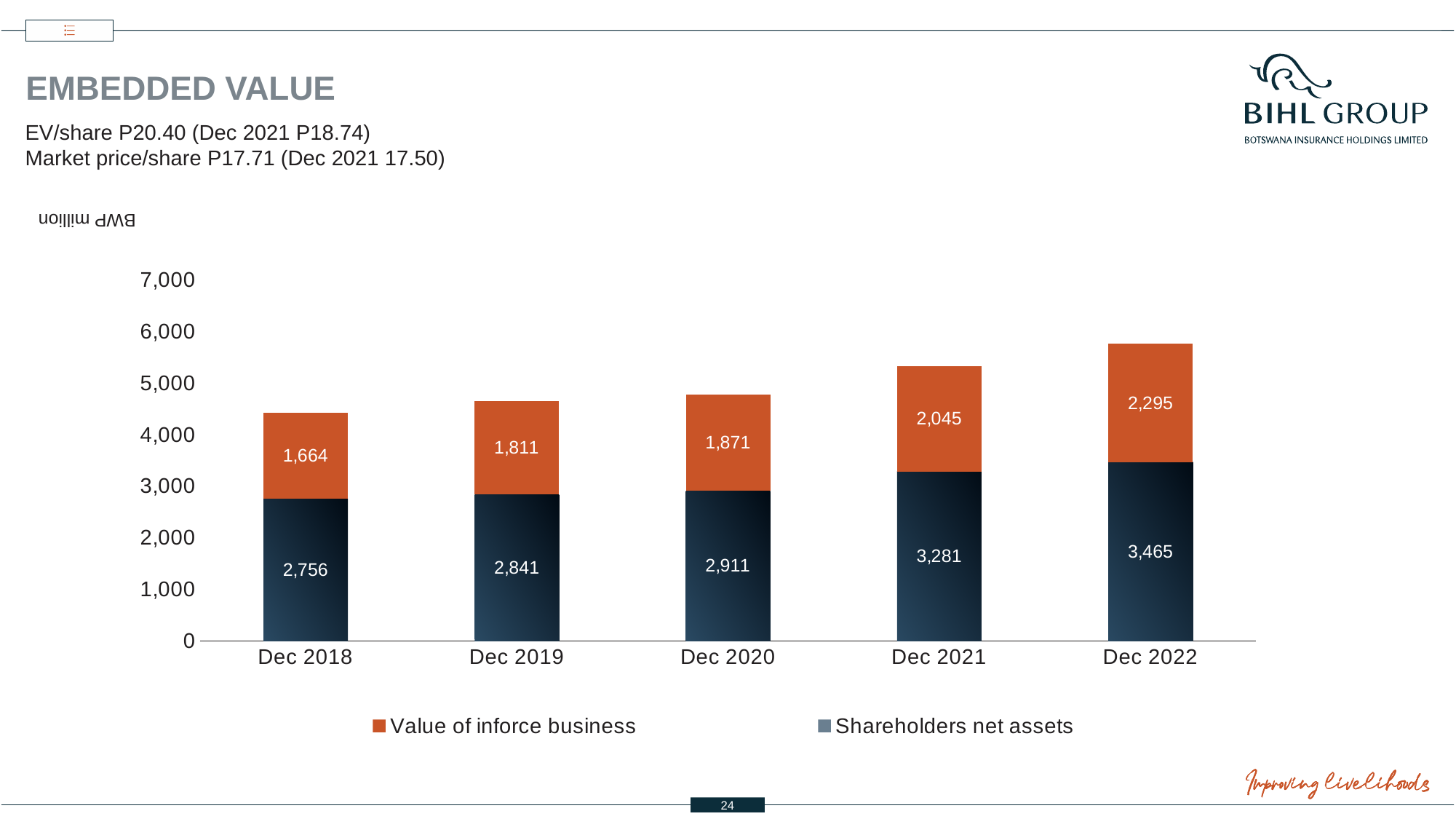
What is the value of Shareholders net assets for Dec 2020? 2,911 How many years are shown on the x axis? 5 How many series does the legend list? 2 What is the total of the stacked bar for Dec 2021? 5,326 Which year has the lowest Shareholders net assets? Dec 2018 What is the difference in Shareholders net assets between Dec 2022 and Dec 2021? 184 What is the value of Shareholders net assets for Dec 2022? 3,465 What is the total of the stacked bar for Dec 2018? 4,420 Which year has the highest Value of inforce business? Dec 2022 Is the Value of inforce business larger in Dec 2020 or Dec 2021? Dec 2021 What is the Value of inforce business for Dec 2019? 1,811 Do the Shareholders net assets values rise or fall from Dec 2018 to Dec 2022? rise